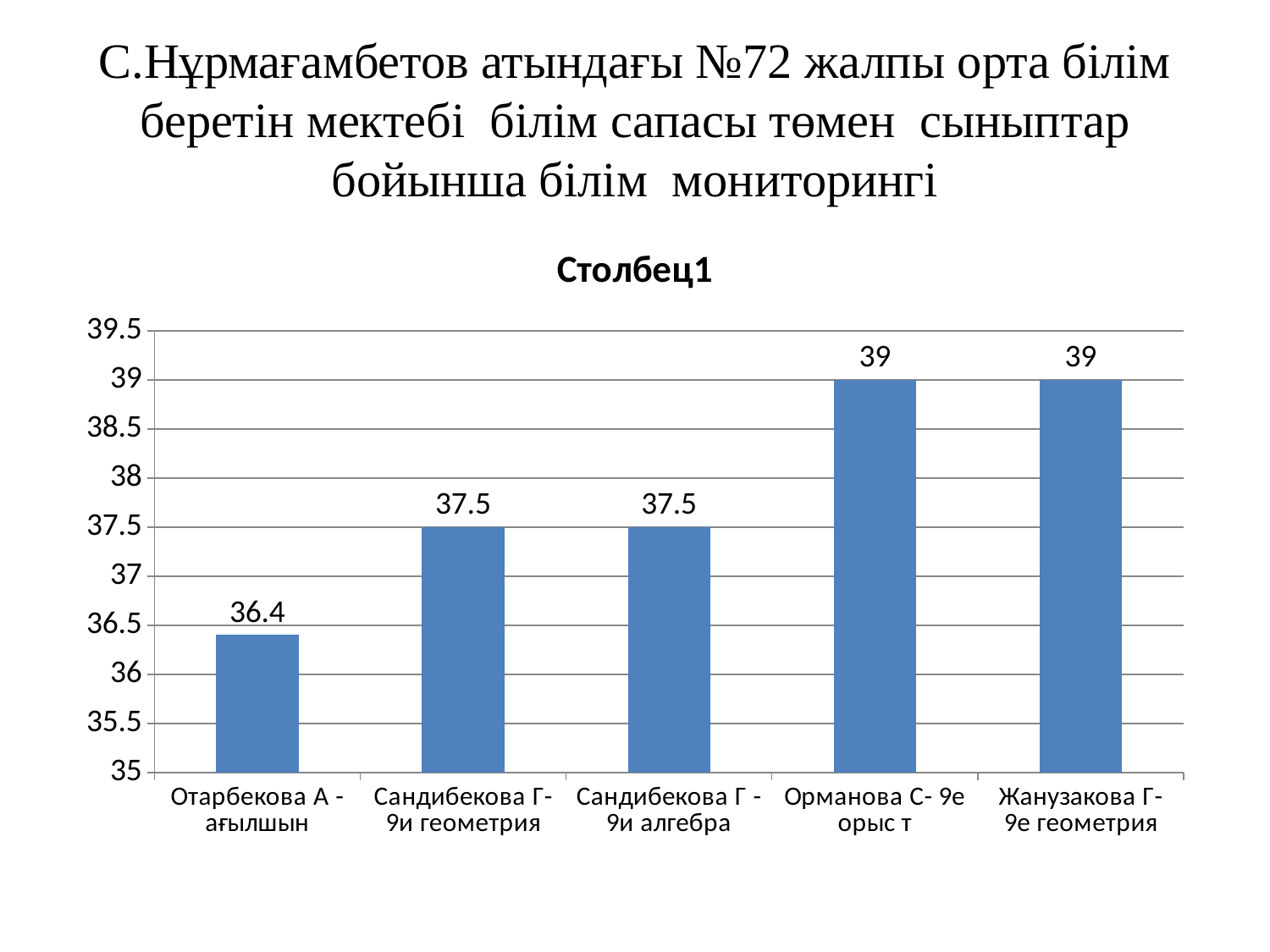
What is the value for Орманова С- 9е орыс т? 39 What kind of chart is shown on the slide? bar chart How many categories are shown in the chart? 5 What is the title of the chart? Столбец1 Is the value for Отарбекова А - ағылшын greater or less than 37? less What is the value for Отарбекова А - ағылшын? 36.4 What is the value for Сандибекова Г- 9и геометрия? 37.5 Which category has the lowest value? Отарбекова А - ағылшын Which is larger, the value for Сандибекова Г- 9и геометрия or the value for Жанузакова Г- 9е геометрия? Жанузакова Г- 9е геометрия What is the value for Жанузакова Г- 9е геометрия? 39 What is the difference between the values for Сандибекова Г - 9и алгебра and Отарбекова А - ағылшын? 1.1 What is the difference between the values for Орманова С- 9е орыс т and Отарбекова А - ағылшын? 2.6